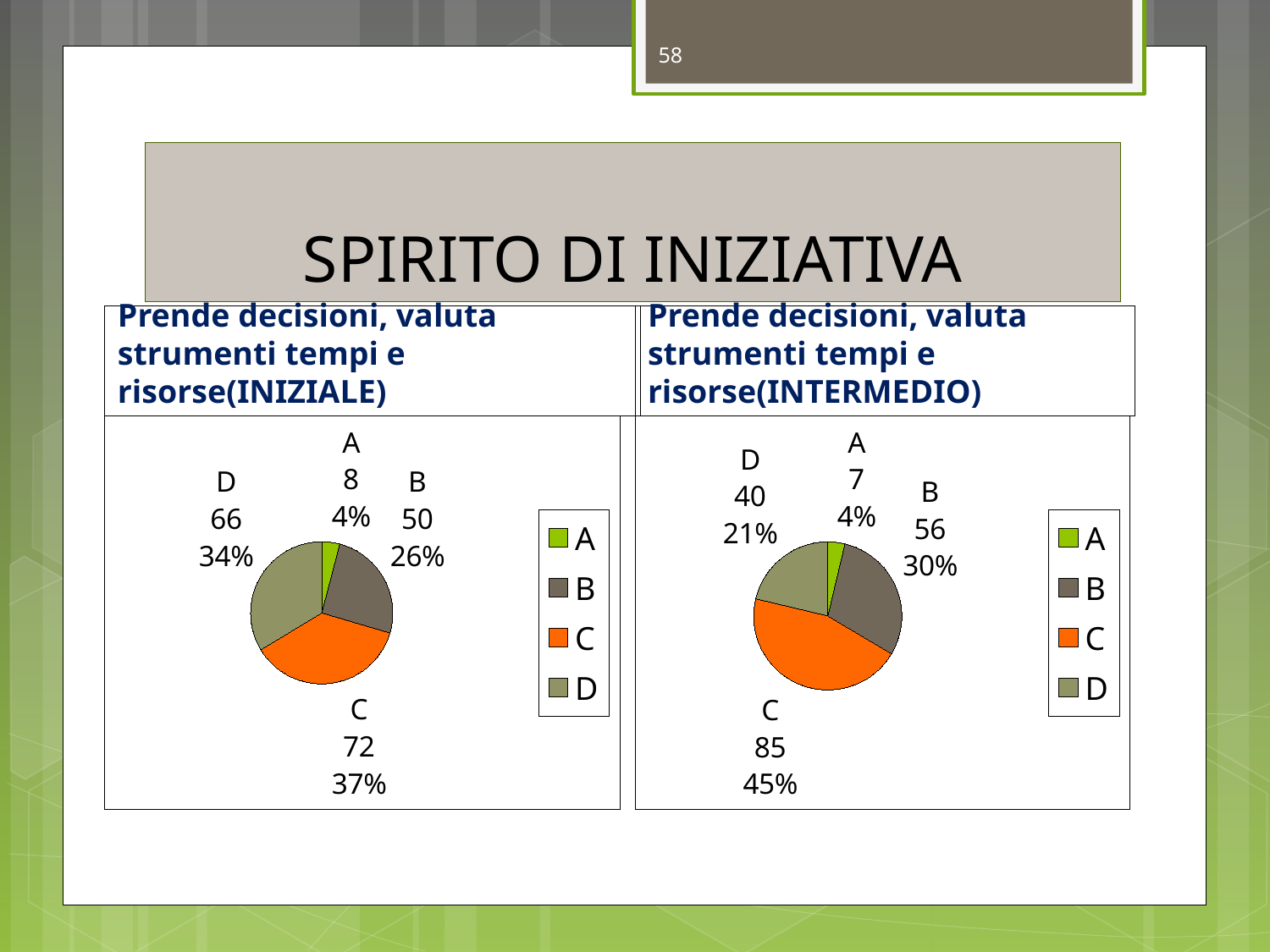
In the INTERMEDIO pie chart (right), what is the value for category B? 56 How many categories does the INIZIALE pie chart (left) show? 4 In the INIZIALE pie chart (left), what percentage share does category D have? 34% In the INIZIALE pie chart (left), what is the value for category C? 72 In the INTERMEDIO pie chart (right), which category has the smallest value? A In the INTERMEDIO pie chart (right), which is larger, the value for B or the value for D? B In the INTERMEDIO pie chart (right), what percentage share does category C have? 45% In the INIZIALE pie chart (left), which category has the largest value? C In the INIZIALE pie chart (left), what colour represents category C in the legend? Orange In the INIZIALE pie chart (left), what is the difference between the values for D and B? 16 What type of chart is used on the right side of the slide (INTERMEDIO)? Pie chart In the INTERMEDIO pie chart (right), what is the difference between the values for C and D? 45